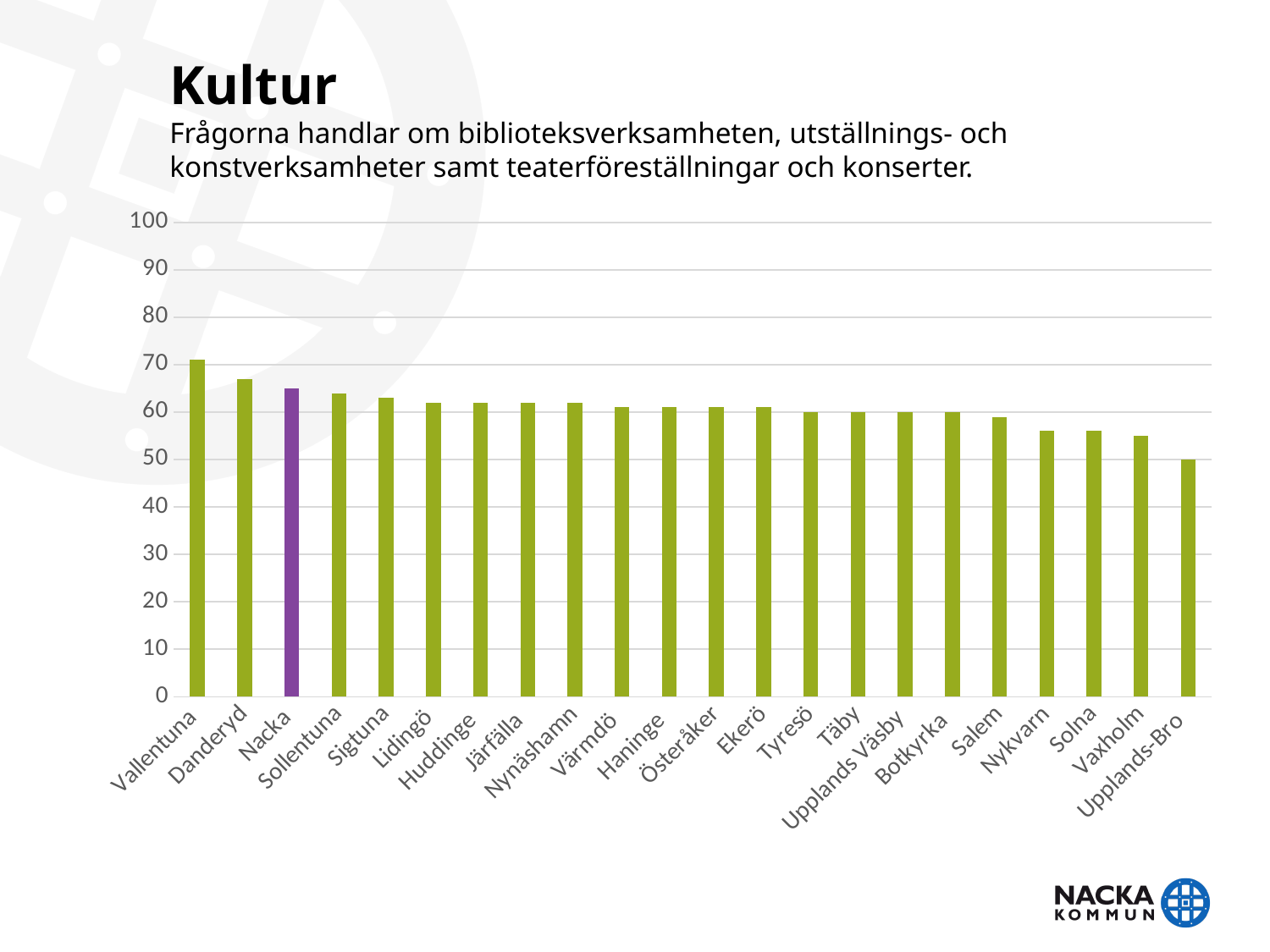
Which municipality has the highest value in the chart? Vallentuna Which has the larger value, Vallentuna or Danderyd? Vallentuna Is the value for Vallentuna greater or less than 60? greater Is the value for Nacka greater or less than 60? greater What kind of chart is shown on the slide? bar chart What is the title of the slide containing the chart? Kultur Which municipality's bar is shown in purple instead of green? Nacka How many municipalities are shown on the x axis of the chart? 22 Which has the larger value, Nacka or Solna? Nacka Do the values rise or fall moving from left to right along the x axis? fall Which municipality has the lowest value in the chart? Upplands-Bro Is the value for Vaxholm greater or less than 60? less